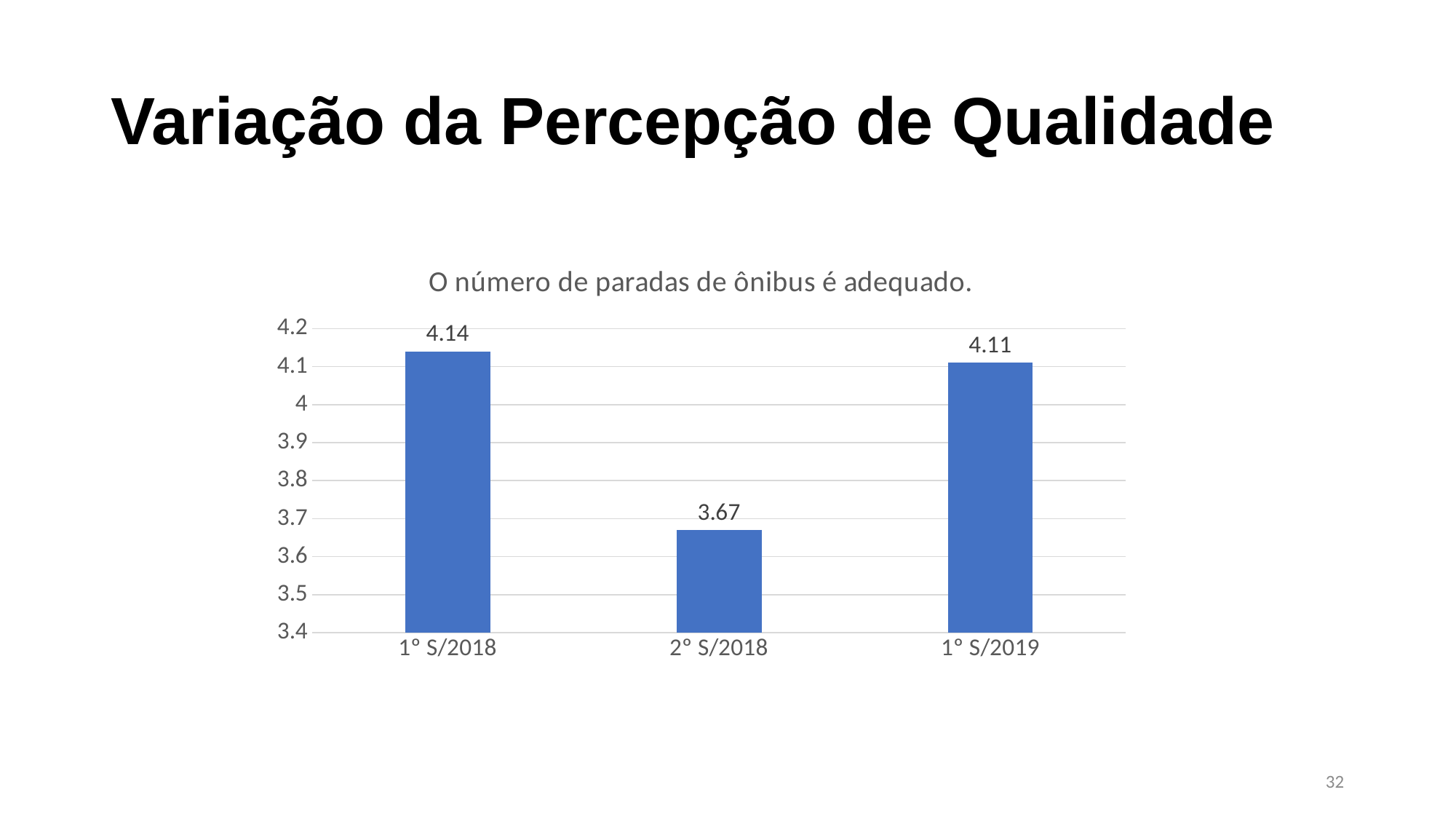
Which is larger, the value for 2° S/2018 or the value for 1° S/2019? 1° S/2019 How many categories are shown on the x axis? 3 What is the difference between the values for 1° S/2018 and 2° S/2018? 0.47 Which category has the highest value? 1° S/2018 What kind of chart is shown on the slide? bar chart What is the difference between the values for 1° S/2019 and 2° S/2018? 0.44 Is the value for 2° S/2018 greater or less than 3.8? less What is the value for 1° S/2019? 4.11 What is the value for 2° S/2018? 3.67 What is the value for 1° S/2018? 4.14 What is the title of the chart? O número de paradas de ônibus é adequado. Which category has the lowest value? 2° S/2018